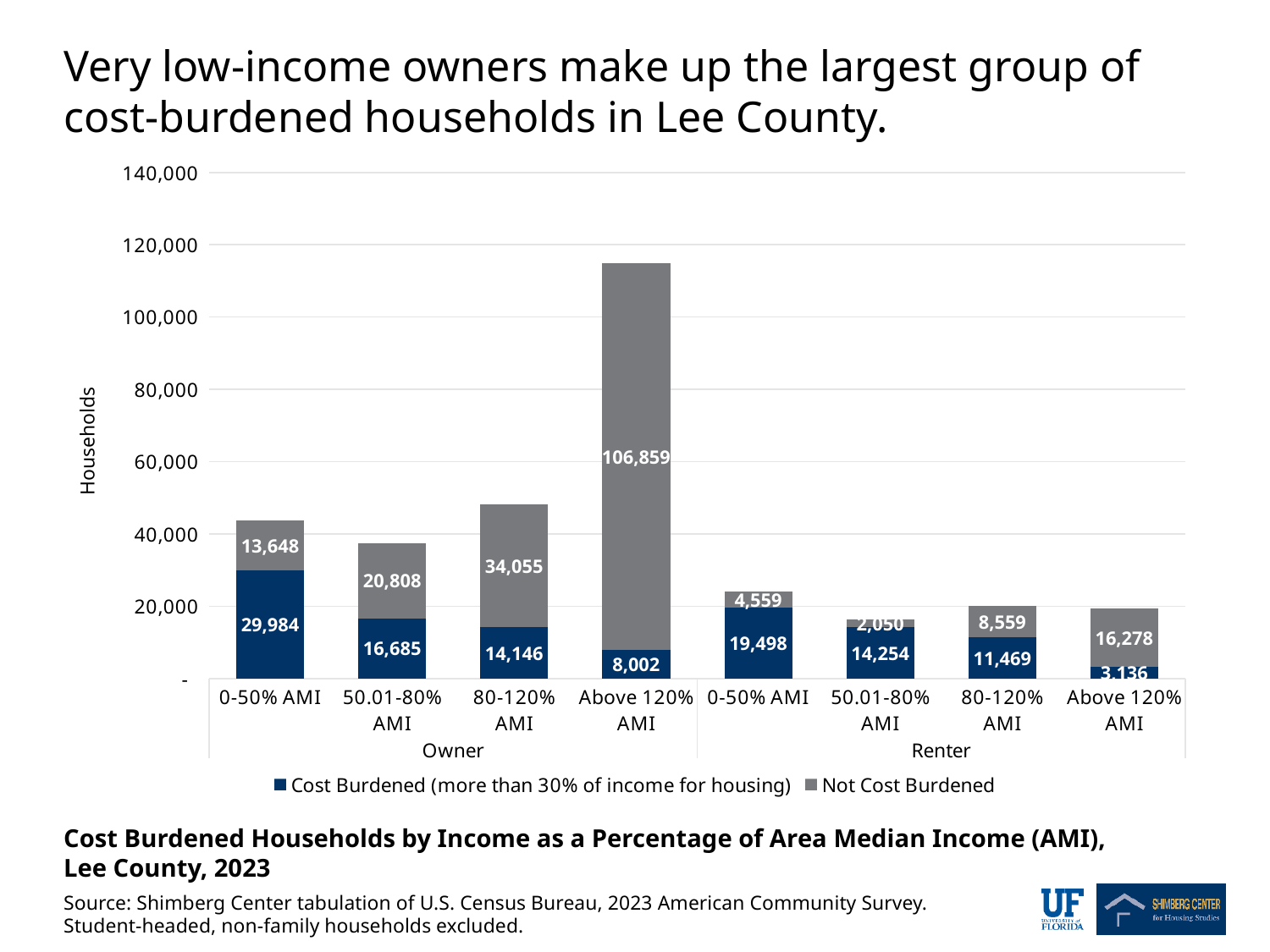
Is the total height of the Owner Above 120% AMI bar greater or less than 100,000? greater What kind of chart is shown on the slide? Stacked bar chart What is the number of not cost-burdened owner households above 120% AMI? 106,859 What is the number of cost-burdened renter households at 50.01-80% AMI? 14,254 What is the difference between cost-burdened owner households at 0-50% AMI and cost-burdened renter households at 0-50% AMI? 10,486 Which is larger: the number of not cost-burdened renter households at 80-120% AMI or at Above 120% AMI? Above 120% AMI Which category has the highest number of cost-burdened households? Owner, 0-50% AMI What is the total number of owner households at 0-50% AMI (cost burdened plus not cost burdened)? 43,632 How many series does the legend list? 2 Which category has the lowest number of cost-burdened households? Renter, Above 120% AMI How many income categories (bars) are plotted in the chart? 8 What is the number of cost-burdened owner households at 0-50% AMI? 29,984